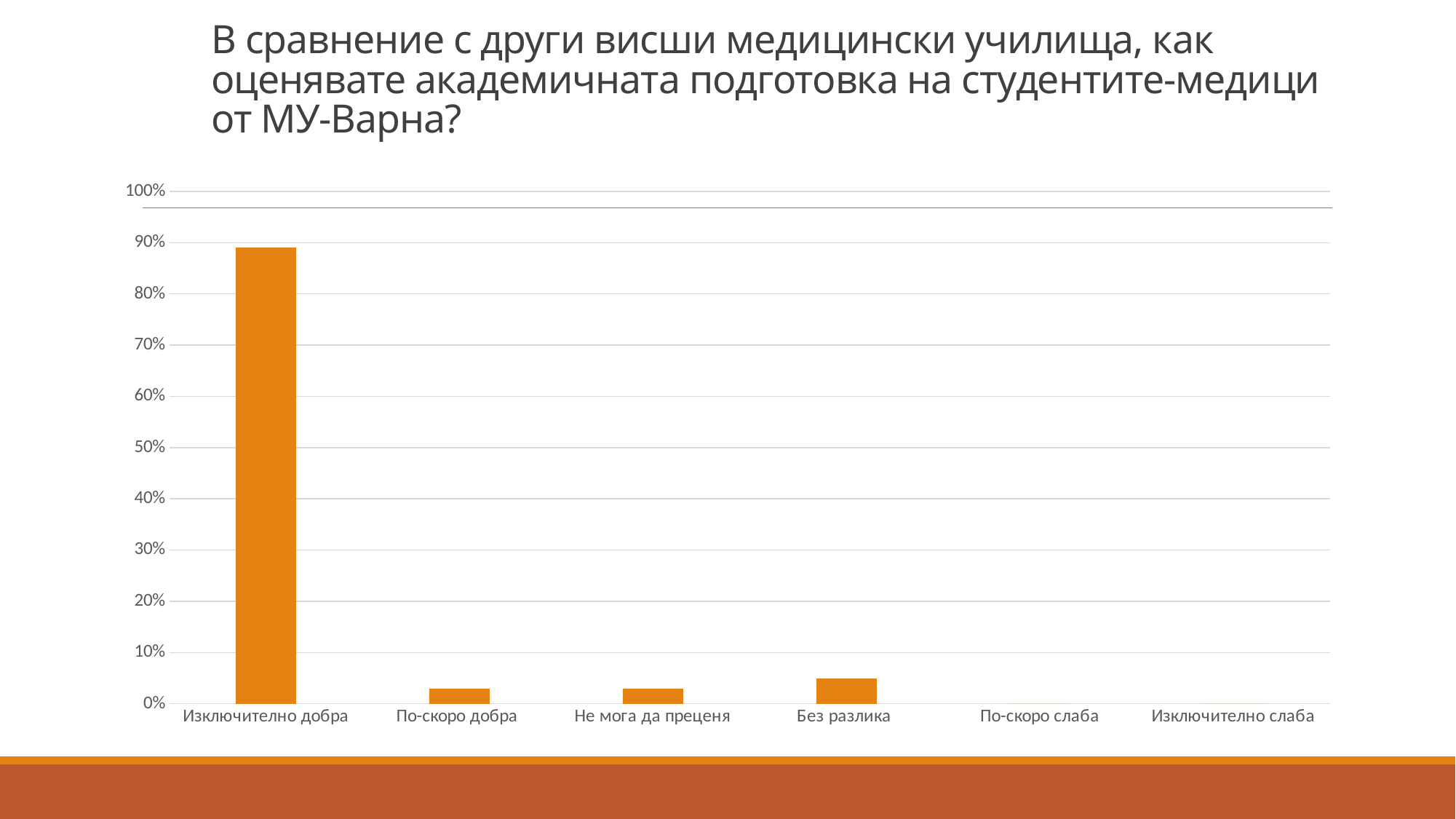
Is the value for Без разлика greater or less than 10%? less How many categories are shown on the x axis of the chart? 6 Which is larger, the value for Изключително добра or the value for Не мога да преценя? Изключително добра How many categories show no visible bar in the chart? 2 Which category has the highest value in the chart? Изключително добра Is the value for Изключително добра greater or less than 50%? greater Which is larger, the value for Без разлика or the value for По-скоро добра? Без разлика What colour are the bars in the chart? orange What kind of chart is shown on the slide? bar chart Is the value for Изключително добра greater or less than 80%? greater What is the highest value shown on the y axis of the chart? 100%